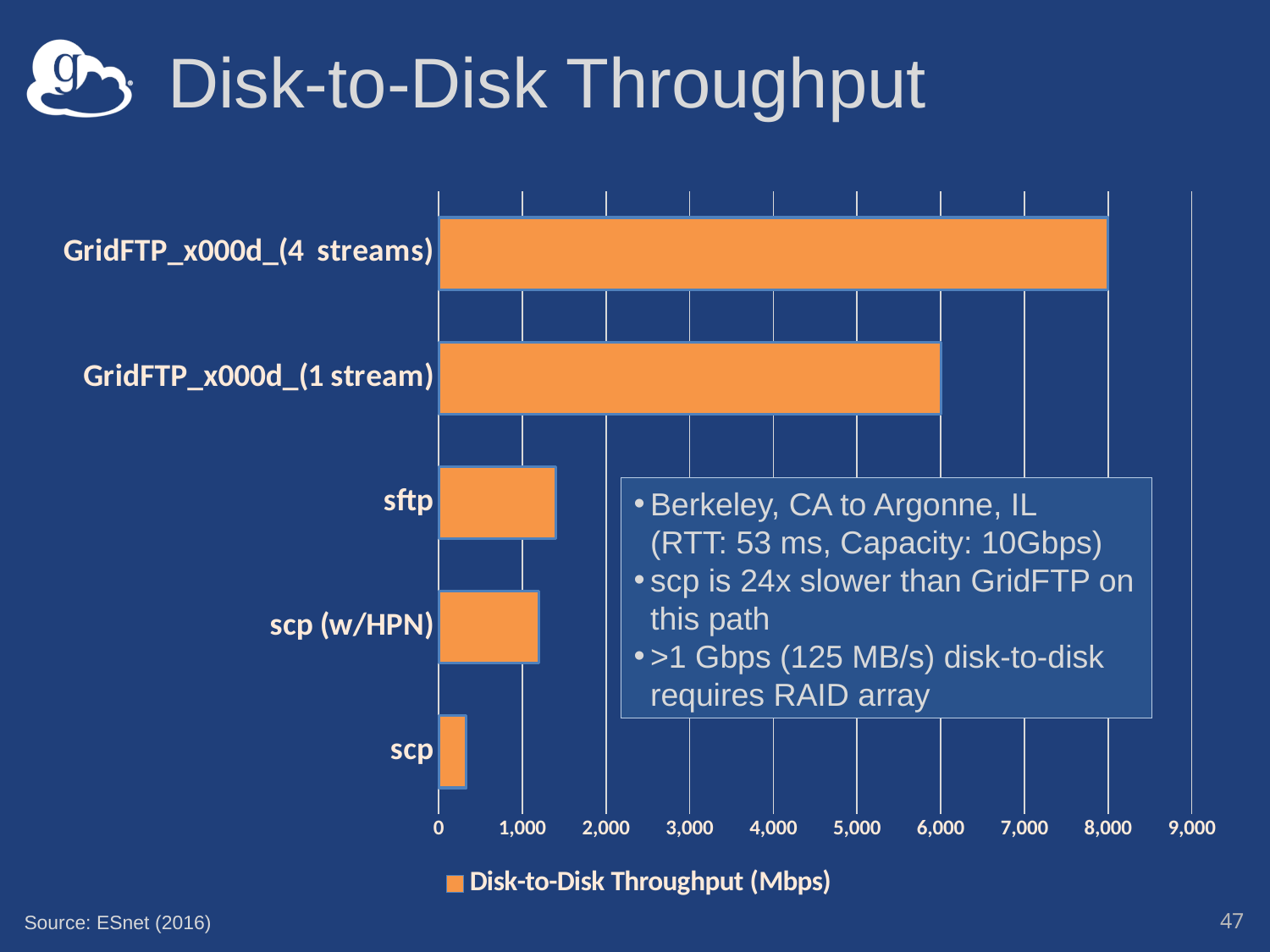
What series name is shown in the chart legend? Disk-to-Disk Throughput (Mbps) How many series does the legend list? 1 How many categories are plotted in the chart? 5 Which category has the highest disk-to-disk throughput? GridFTP (4 streams) Is the value for scp greater or less than 1,000? less Is the value for sftp greater or less than 1,000? greater What kind of chart is shown on the slide? bar chart Is the value for GridFTP (1 stream) greater or less than 5,000? greater Which has the larger throughput, GridFTP (4 streams) or GridFTP (1 stream)? GridFTP (4 streams) Which category has the lowest disk-to-disk throughput? scp What is the title of the slide containing the chart? Disk-to-Disk Throughput